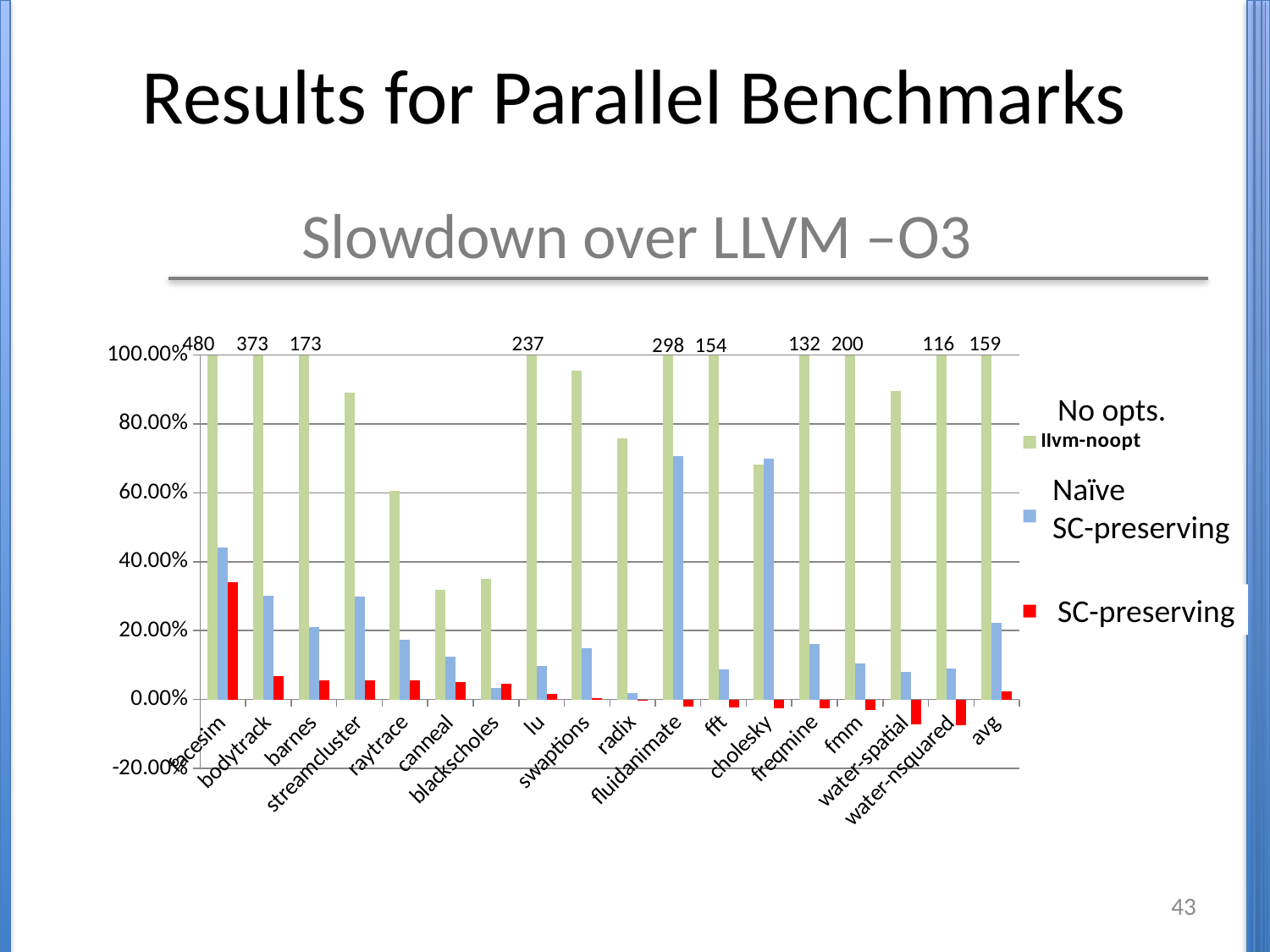
What is the title of the chart? Slowdown over LLVM –O3 What value is printed above the llvm-noopt bar for facesim? 480 Is the Naïve SC-preserving value for fluidanimate greater or less than 60.00%? greater How many series does the chart's legend list? 3 Is the Naïve SC-preserving value for facesim greater or less than 40.00%? greater Is the llvm-noopt value for canneal greater or less than 40.00%? less What kind of chart is shown on the slide? bar chart What value is printed above the llvm-noopt bar for fluidanimate? 298 Which benchmark has the highest SC-preserving (red) value? facesim How many benchmark categories are shown on the x axis of the chart? 18 For facesim, which is larger: the Naïve SC-preserving value or the SC-preserving value? Naïve SC-preserving What value is printed above the llvm-noopt bar for avg? 159